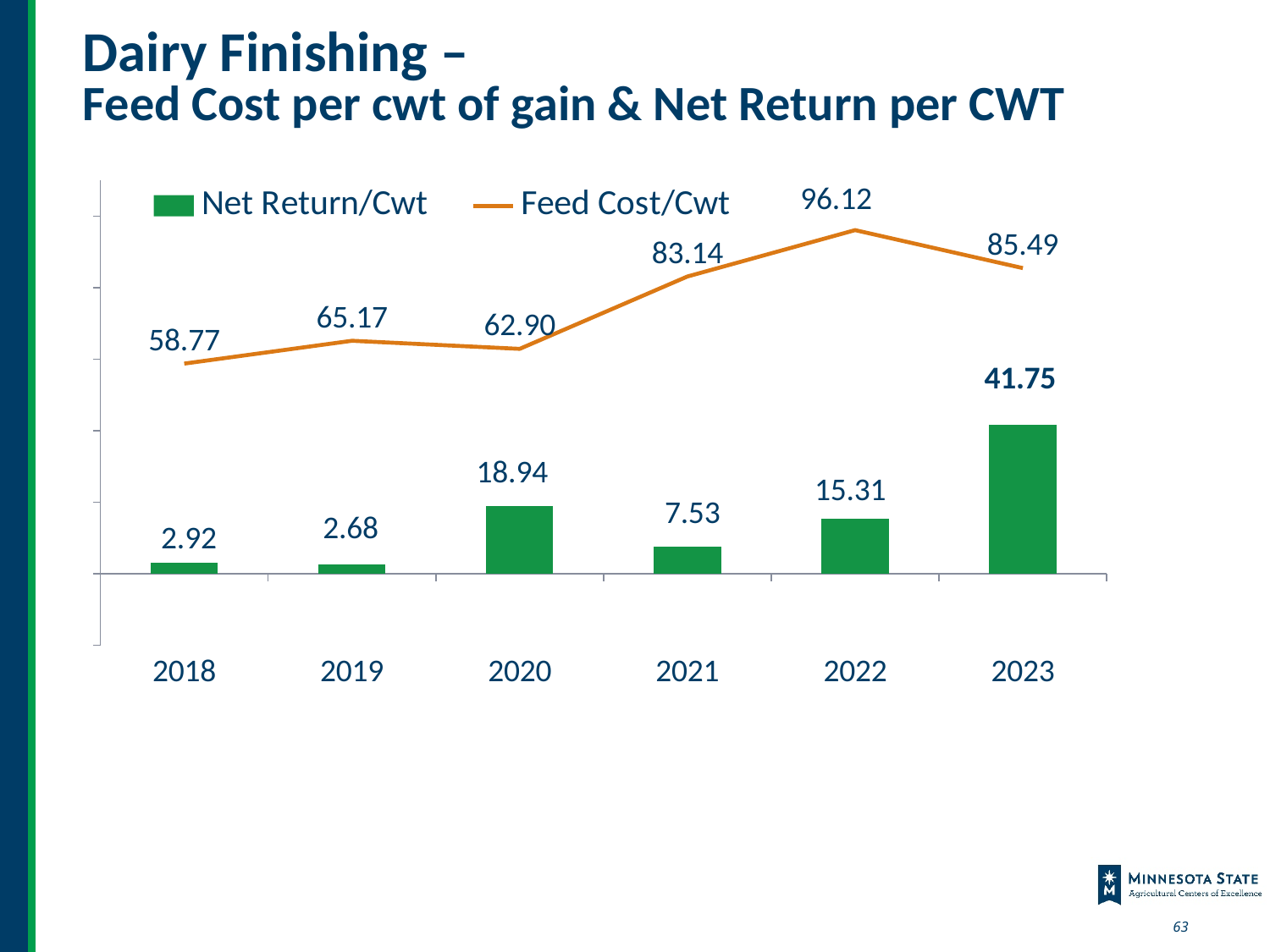
How many years are shown on the x axis? 6 What is the Net Return/Cwt value for 2023? 41.75 What kind of chart is used to show Net Return/Cwt? Bar chart How many series does the legend list? 2 What is the Feed Cost/Cwt value for 2022? 96.12 What is the difference between the Net Return/Cwt in 2023 and in 2022? 26.44 Which series is shown as an orange line? Feed Cost/Cwt Which is larger, the Feed Cost/Cwt in 2019 or in 2020? 2019 Which year has the lowest Net Return/Cwt? 2019 What is the Feed Cost/Cwt value for 2018? 58.77 Which year has the highest Feed Cost/Cwt? 2022 What is the Net Return/Cwt value for 2021? 7.53